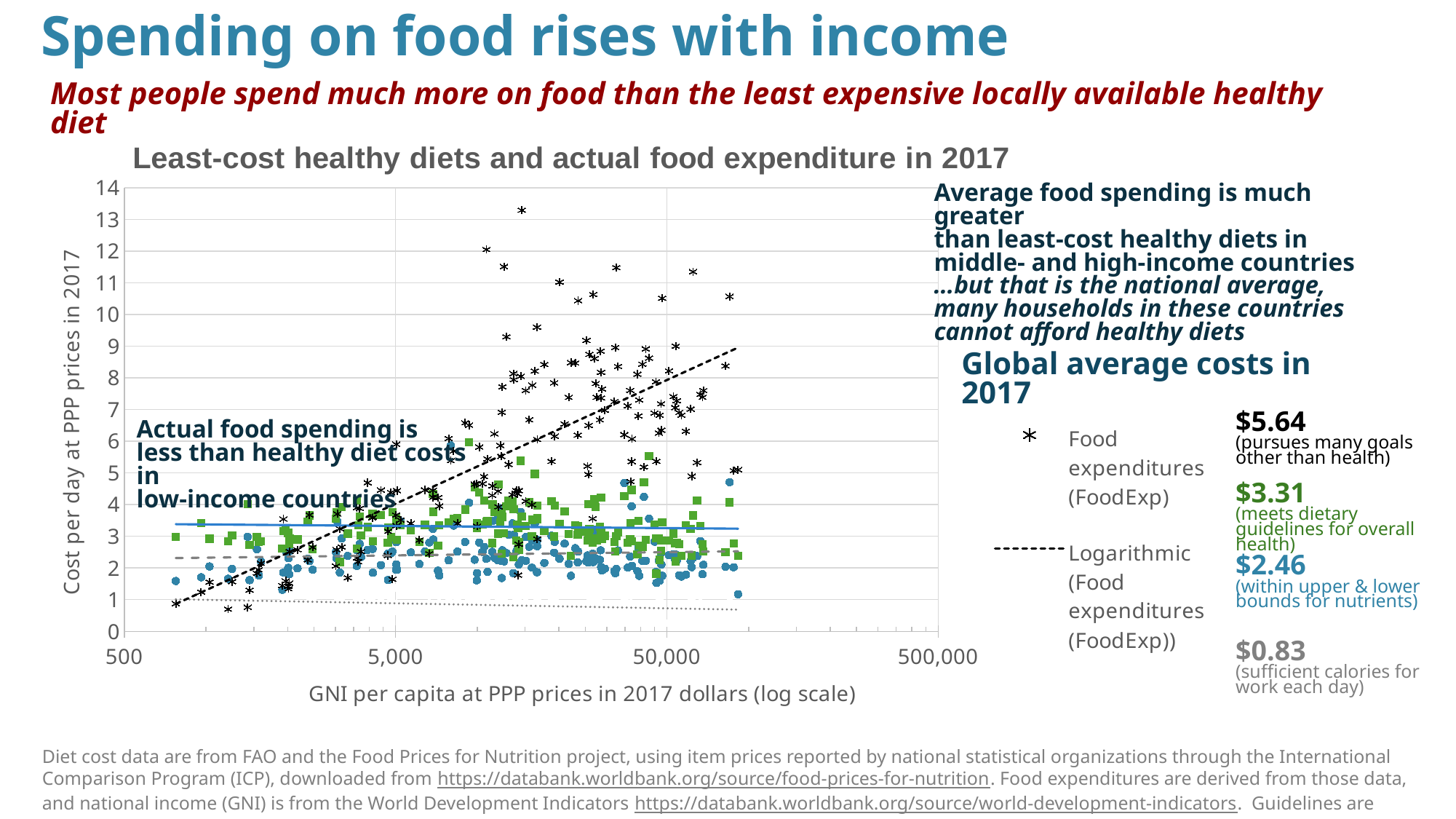
What kind of chart is shown on the slide? Scatter chart What is the difference between the global average food expenditure ($5.64) and the cost of a diet with sufficient calories for work each day ($0.83)? $4.81 What is the label of the chart's x axis? GNI per capita at PPP prices in 2017 dollars (log scale) What is the title of the chart? Least-cost healthy diets and actual food expenditure in 2017 Is the highest food expenditure point on the chart greater or less than 13? greater What is the label of the chart's y axis? Cost per day at PPP prices in 2017 According to the slide, what is the global average cost in 2017 of food expenditures? $5.64 How many entries does the chart's legend list? 2 Does the logarithmic trend line for food expenditures rise or fall as GNI per capita increases? Rises According to the slide, what is the global average cost in 2017 of a diet within upper and lower bounds for nutrients? $2.46 According to the slide, what is the global average cost in 2017 of a diet that meets dietary guidelines for overall health? $3.31